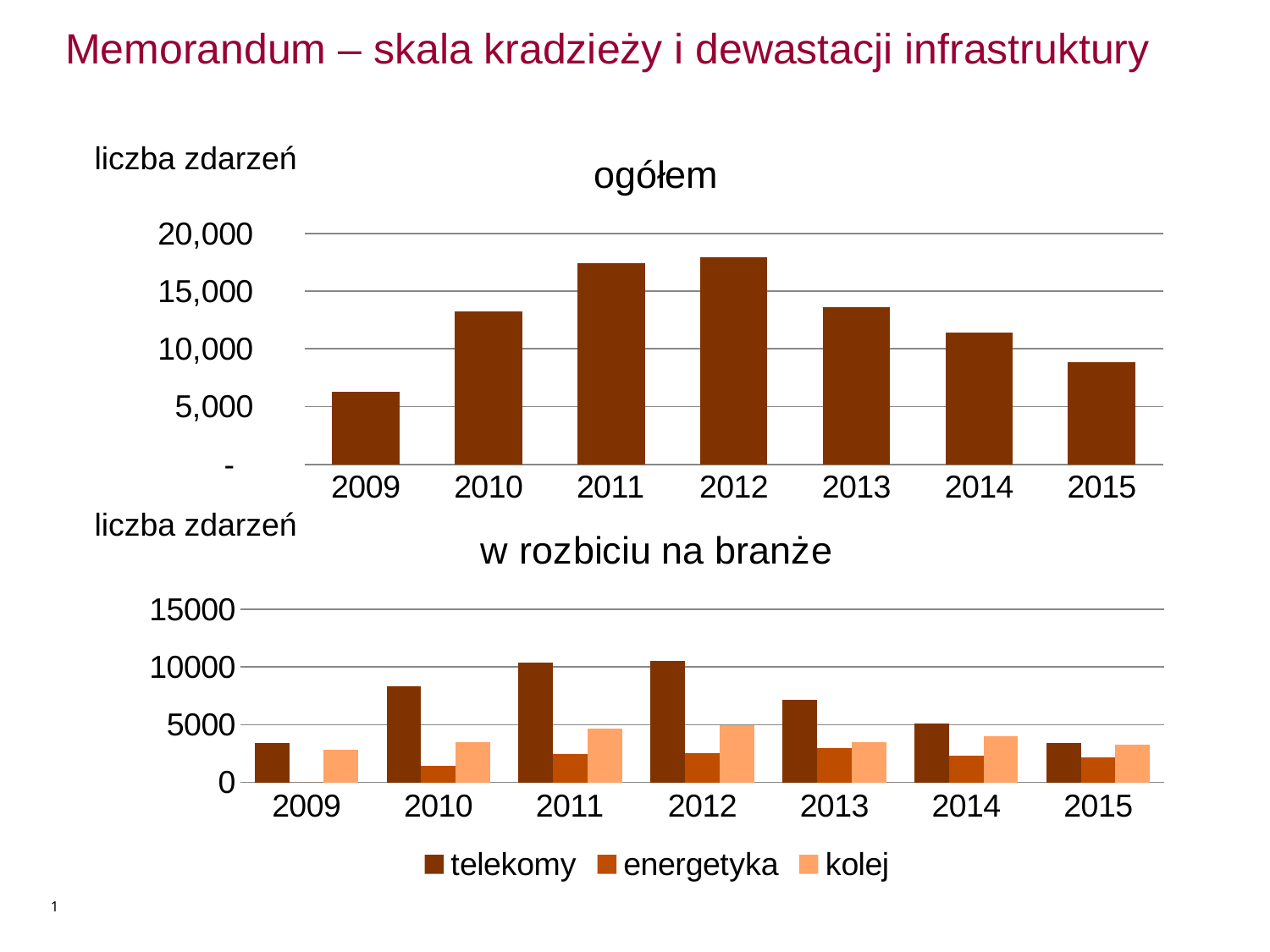
On the chart titled "w rozbiciu na branże", how many series does the legend list? 3 On the chart titled "ogółem", which year has the highest value? 2012 On the chart titled "ogółem", what kind of chart is shown? bar chart On the chart titled "ogółem", is the value for 2011 greater or less than 15,000? greater On the chart titled "ogółem", which year has the lowest value? 2009 On the chart titled "ogółem", which year has the larger value, 2010 or 2014? 2010 On the chart titled "ogółem", how many years are plotted on the x axis? 7 On the chart titled "ogółem", do the values rise or fall from 2012 to 2015? fall On the chart titled "w rozbiciu na branże", which series has the larger value in 2012, kolej or energetyka? kolej On the chart titled "w rozbiciu na branże", what are the legend entries? telekomy, energetyka, kolej On the chart titled "ogółem", is the value for 2009 greater or less than 10,000? less